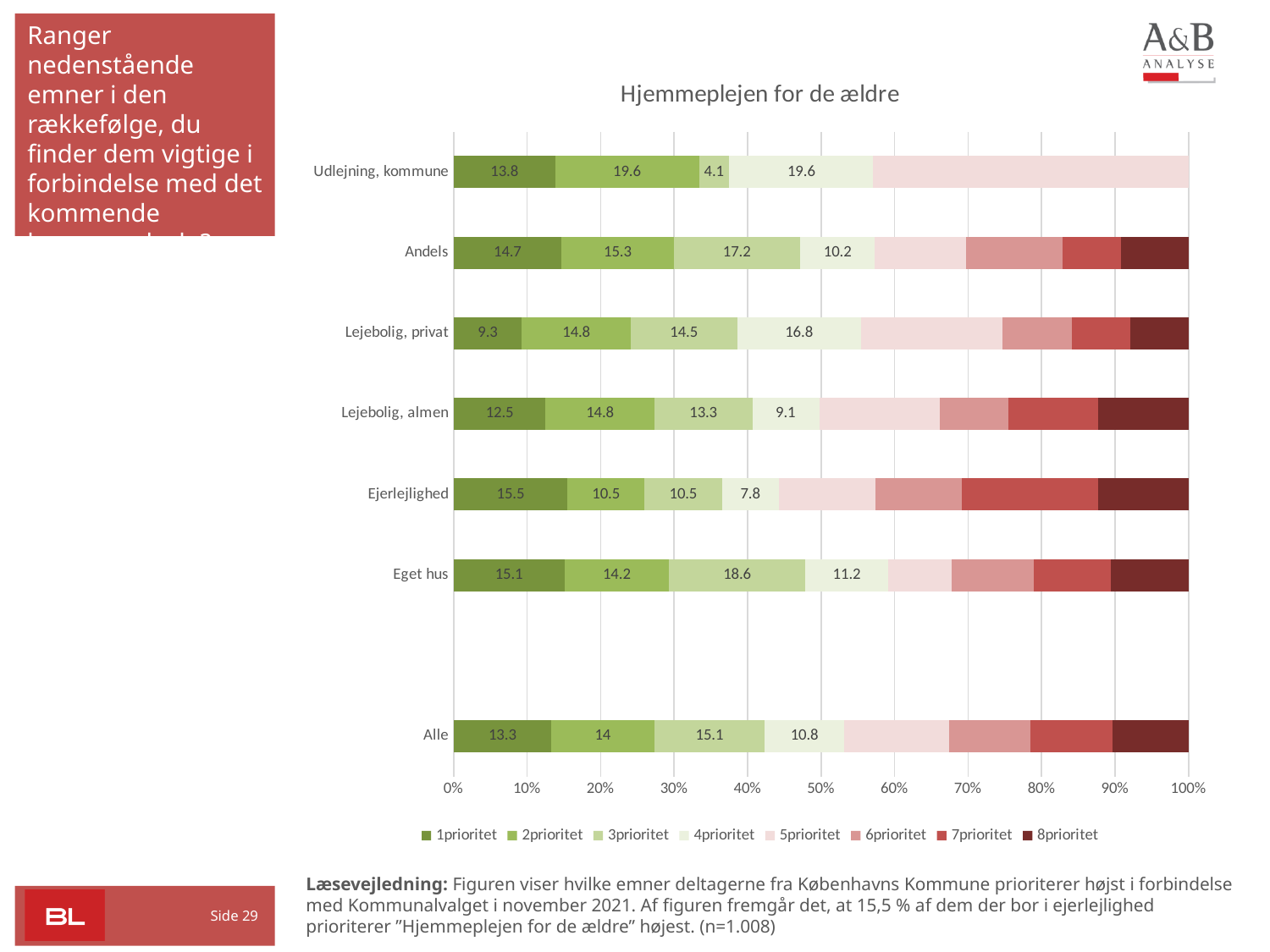
Which is larger for Andels: the 3prioritet value or the 4prioritet value? 3prioritet What kind of chart is shown? Stacked bar chart Which category has the lowest value for 1prioritet? Lejebolig, privat What is the value for 1prioritet for Ejerlejlighed? 15.5 How many categories are shown on the y axis? 7 What is the title of the chart? Hjemmeplejen for de ældre How many series does the legend list? 8 Which category has the highest value for 1prioritet? Ejerlejlighed What is the value for 3prioritet for Eget hus? 18.6 What is the value for 4prioritet for Udlejning, kommune? 19.6 What is the difference between the 2prioritet and 3prioritet values for Udlejning, kommune? 15.5 What is the value for 2prioritet for Alle? 14